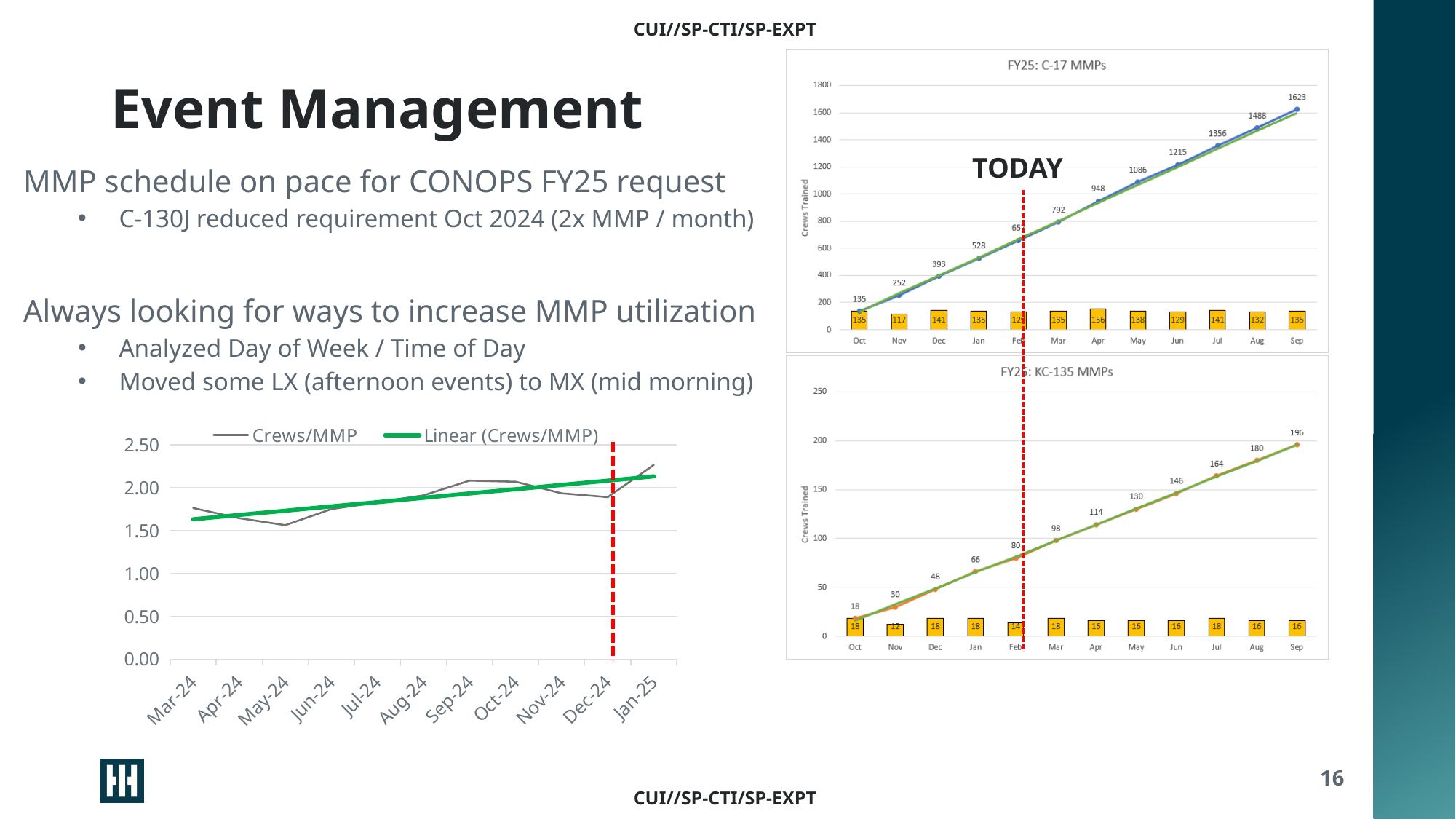
In the FY25: KC-135 MMPs chart, does the cumulative Crews Trained line rise or fall from Oct to Sep? rise In the FY25: C-17 MMPs chart, what is the cumulative Crews Trained value for Sep? 1623 In the FY25: C-17 MMPs chart, what is the cumulative Crews Trained value for Mar? 792 In the FY25: KC-135 MMPs chart, which month has the lowest monthly bar value? Nov In the FY25: C-17 MMPs chart, is the cumulative value for Jun larger than the cumulative value for May? Yes In the FY25: C-17 MMPs chart, which month has the highest monthly bar value? Apr In the FY25: KC-135 MMPs chart, how many months are shown on the x axis? 12 In the bottom-left Crews/MMP chart, how many series does the legend list? 2 In the FY25: C-17 MMPs chart, what is the difference between the cumulative values for Dec and Nov? 141 In the FY25: KC-135 MMPs chart, what is the difference between the cumulative values for Sep and Aug? 16 In the FY25: KC-135 MMPs chart, what is the cumulative Crews Trained value for Jul? 164 In the bottom-left Crews/MMP chart, is the Crews/MMP value for Jan-25 greater or less than 2.00? greater